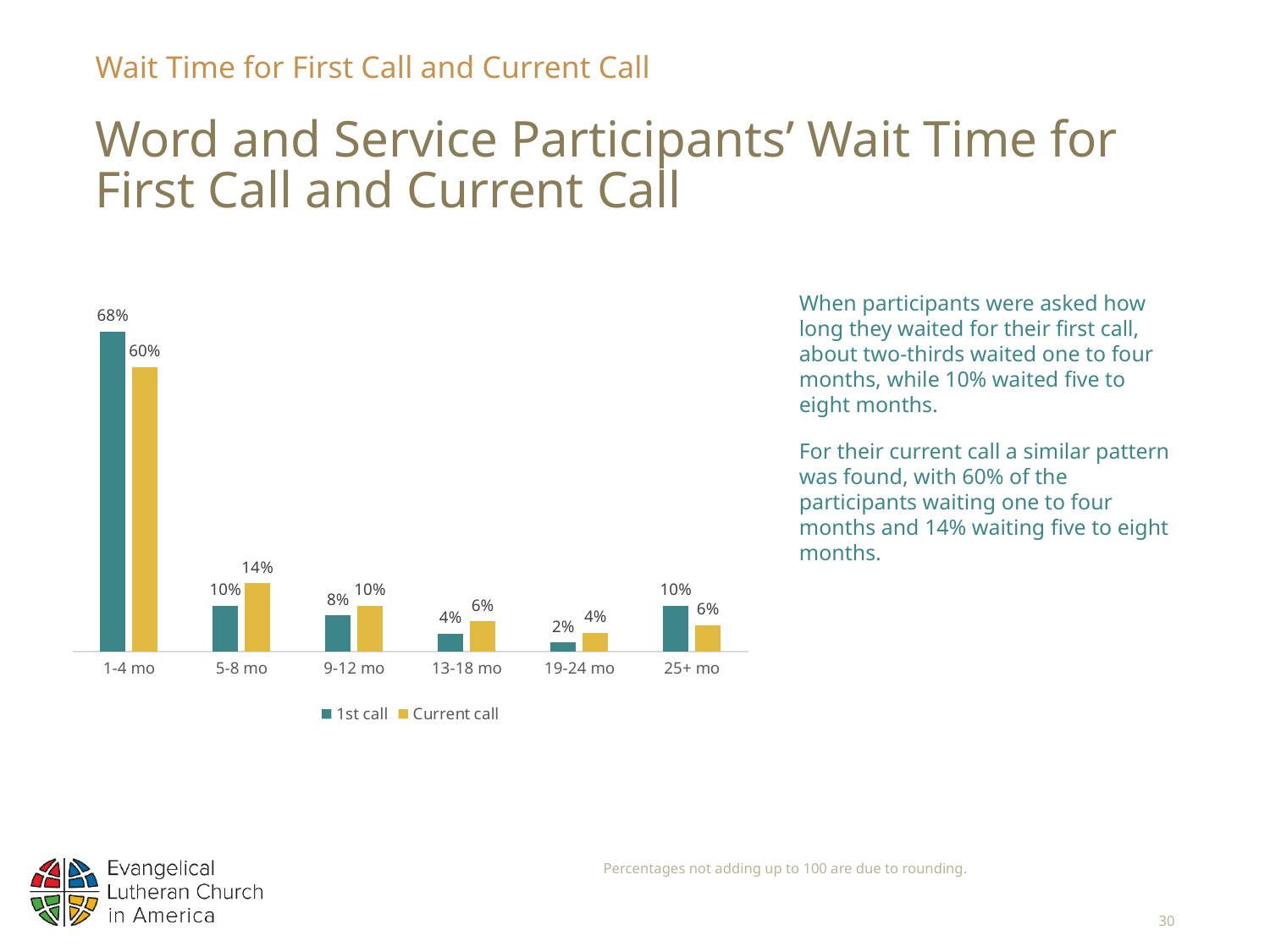
Which wait-time category has the lowest value for the Current call series? 19-24 mo What percentage of participants waited 5-8 months for their current call? 14% Which wait-time category has the highest value for the 1st call series? 1-4 mo How many series does the legend list? 2 What percentage of participants waited 1-4 months for their 1st call? 68% What kind of chart is shown on the slide? Bar chart What is the value for 19-24 mo in the 1st call series? 2% For 25+ mo, which is larger: the 1st call value or the Current call value? 1st call How many wait-time categories are shown on the x axis? 6 Which series is shown in yellow in the legend? Current call What is the difference between the 1st call and Current call values for 1-4 mo? 8% What is the value for 25+ mo in the Current call series? 6%